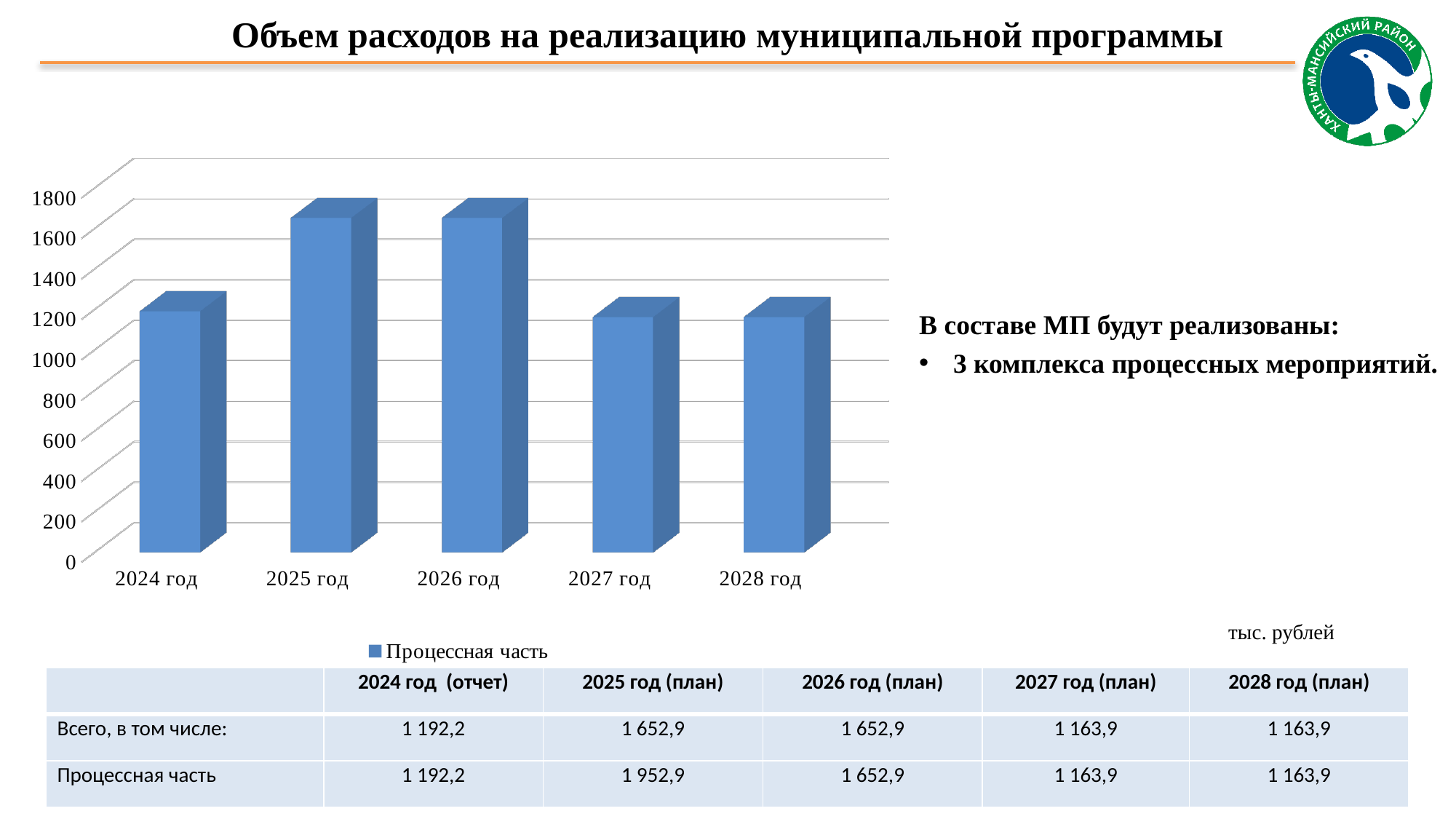
What kind of chart is shown on the slide? bar chart Is the value for 2028 год greater or less than 800? greater Is the value for 2025 год greater or less than 1400? greater Does the value rise or fall from 2024 год to 2025 год? rise Is the value for 2024 год greater or less than 1000? greater What is the name of the series shown in the chart legend? Процессная часть What is the title of the slide containing the chart? Объем расходов на реализацию муниципальной программы Which is larger, the value for 2025 год or the value for 2027 год? 2025 год How many categories (years) are shown on the x axis of the chart? 5 How many series does the chart legend list? 1